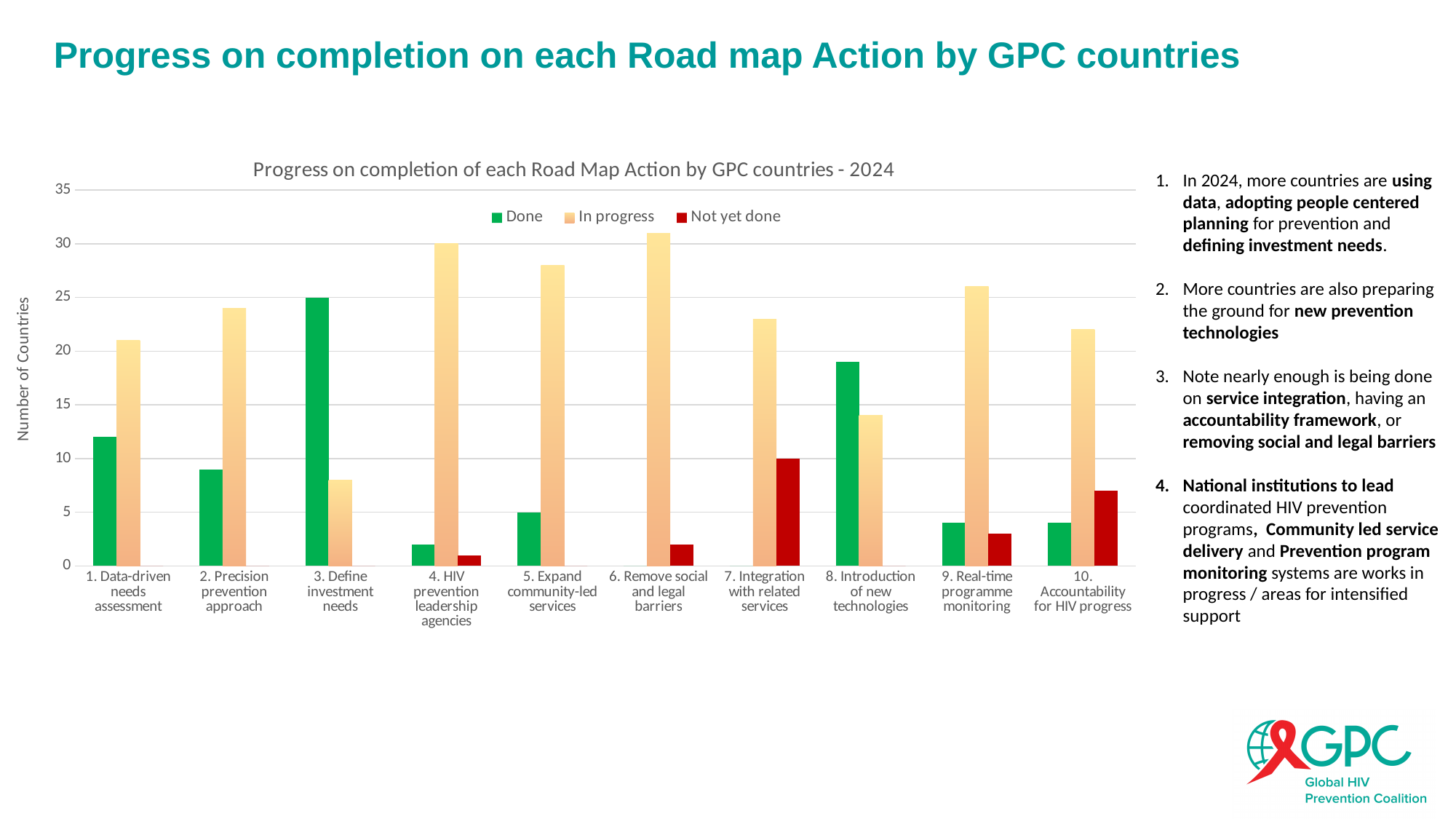
How many series does the chart legend list? 3 What kind of chart is shown on the slide? bar chart What is the Not yet done value for "7. Integration with related services"? 10 Is the In progress value for "3. Define investment needs" greater or less than 10? less Which category has the highest Not yet done value? 7. Integration with related services What is the In progress value for "4. HIV prevention leadership agencies"? 30 How many Road Map Action categories are shown on the x axis? 10 Which category has the highest Done value? 3. Define investment needs Which is larger: the Done value for "8. Introduction of new technologies" or the Done value for "1. Data-driven needs assessment"? 8. Introduction of new technologies What is the Done value for "3. Define investment needs"? 25 Is the Done value for "1. Data-driven needs assessment" greater or less than 10? greater